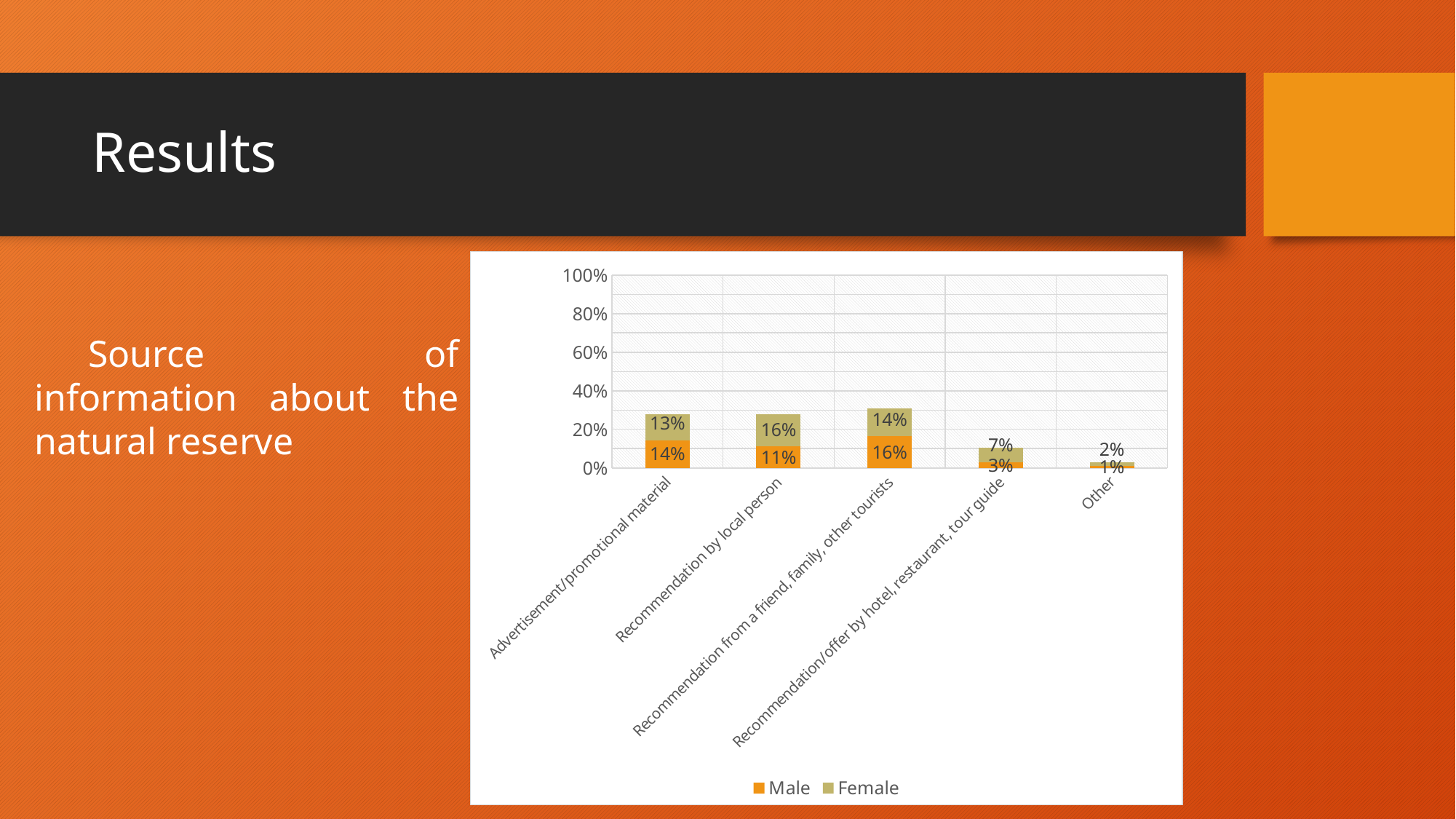
How many categories are shown on the x axis? 5 What is the Female value for Recommendation/offer by hotel, restaurant, tour guide? 7% What is the Male value for Recommendation from a friend, family, other tourists? 16% Which category has the highest Female value? Recommendation by local person What is the difference between the Female and Male values for Recommendation by local person? 5% Which category has the lowest Male value? Other What is the Male value for Advertisement/promotional material? 14% Which is larger for Recommendation/offer by hotel, restaurant, tour guide: the Male value or the Female value? Female What is the Female value for Recommendation by local person? 16% What is the total of the stacked bar for Recommendation from a friend, family, other tourists? 30% How many series does the legend list? 2 What kind of chart is shown on the slide? Stacked bar chart